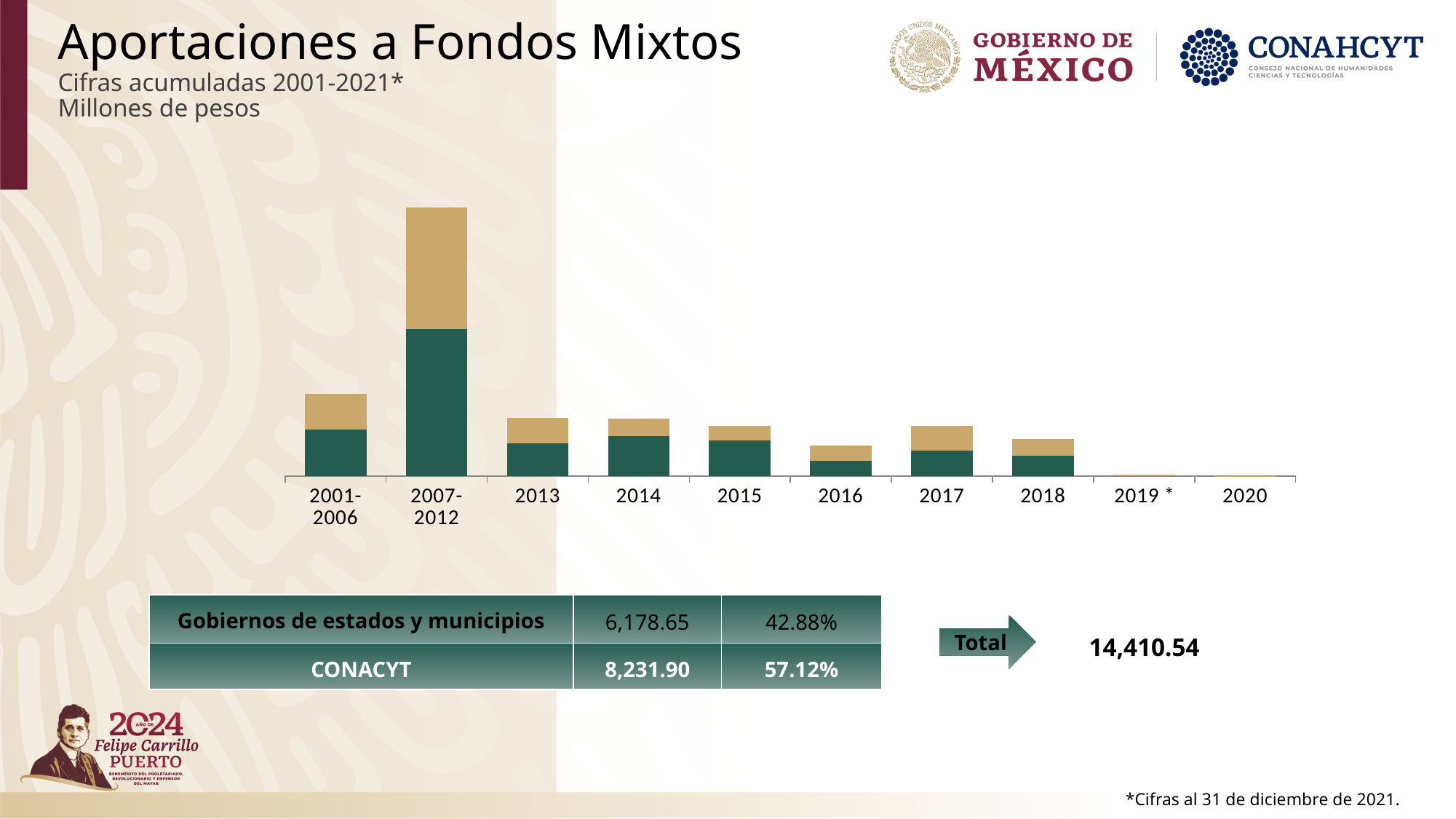
According to the table below the chart, what is the accumulated contribution of CONACYT? 8,231.90 What kind of chart is shown on the slide? Stacked bar chart What is the total of contributions shown on the slide? 14,410.54 What is the title of the slide containing the chart? Aportaciones a Fondos Mixtos What is the difference between the CONACYT contribution and the Gobiernos de estados y municipios contribution? 2,053.25 Do the bars rise or fall from 2013 to 2016? Fall Which bar is taller, 2016 or 2017? 2017 How many categories are shown along the x axis of the chart? 10 According to the table below the chart, what is the accumulated contribution of Gobiernos de estados y municipios? 6,178.65 What percentage share of the total corresponds to CONACYT? 57.12% Which bar is taller, 2001-2006 or 2013? 2001-2006 Which category has the tallest bar in the chart? 2007-2012